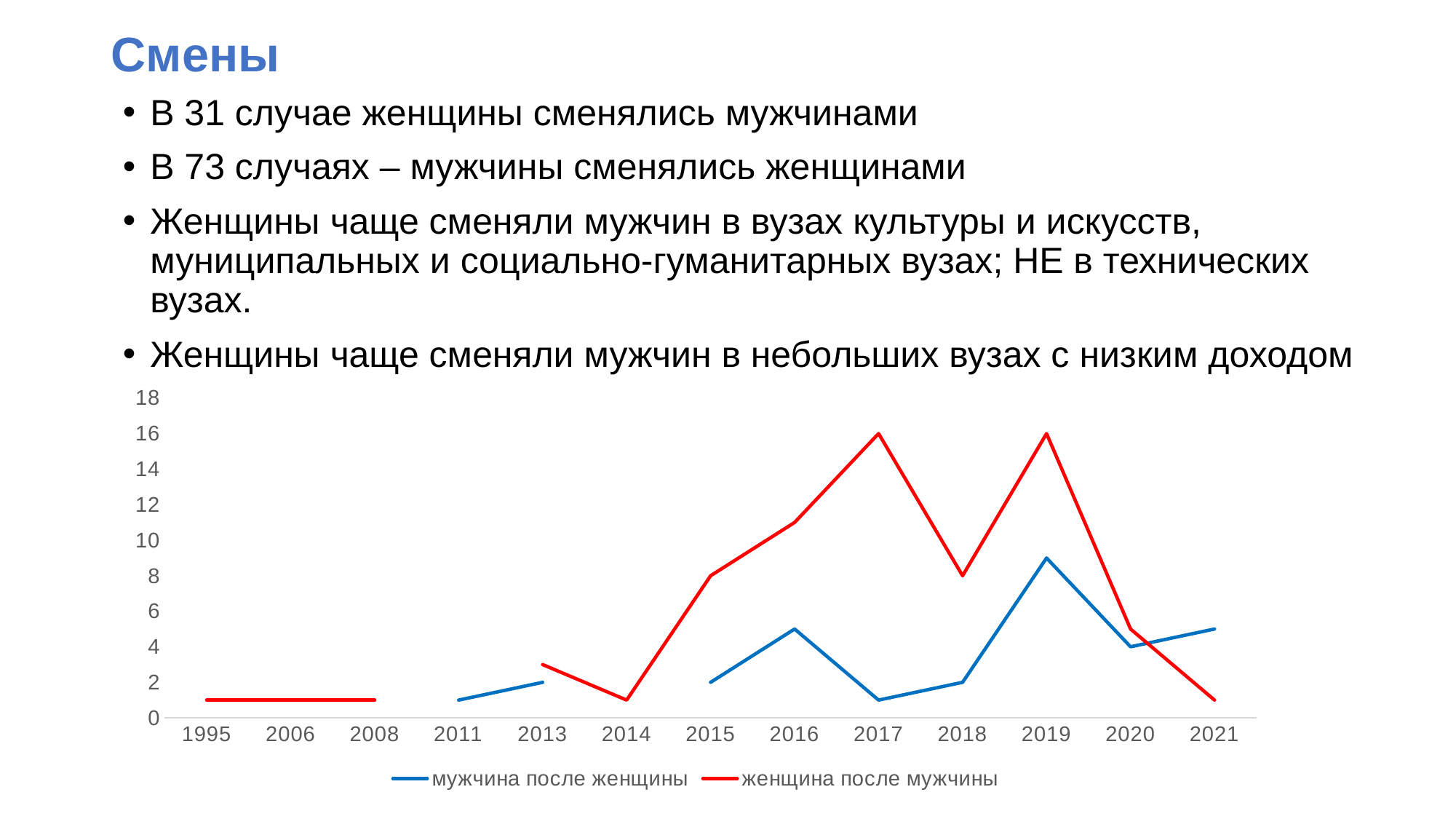
What is the value of the 'мужчина после женщины' series in 2020? 4 What is the difference between the 'женщина после мужчины' values in 2017 and 2018? 8 Is the value of the 'женщина после мужчины' series in 2016 greater or less than 10? greater What type of chart is shown on the slide? line chart In which year does the 'мужчина после женщины' series reach its highest value? 2019 What is the value of the 'женщина после мужчины' series in 2017? 16 Which colour is used for the 'женщина после мужчины' series line? red In 2021, which series has the larger value: 'мужчина после женщины' or 'женщина после мужчины'? мужчина после женщины In 2017, which series has the larger value: 'мужчина после женщины' or 'женщина после мужчины'? женщина после мужчины What is the value of the 'женщина после мужчины' series in 2018? 8 How many years are shown on the x axis of the chart? 13 How many series does the chart legend list? 2